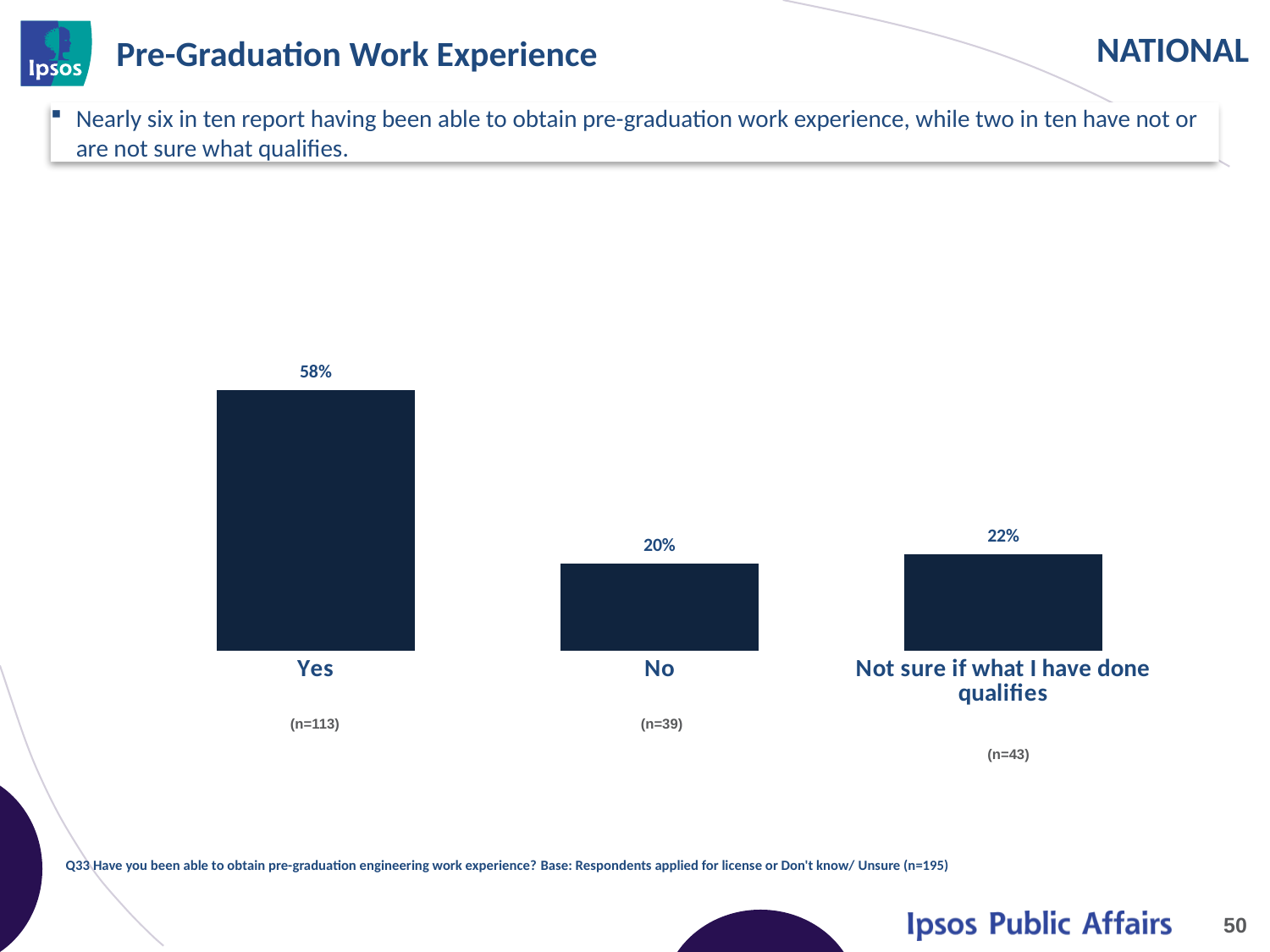
What percentage of respondents answered "Yes"? 58% What is the difference in percentage points between "Yes" and "No"? 38 Which response category has the highest value? Yes Which is larger, the value for "Yes" or the value for "Not sure if what I have done qualifies"? Yes Which response category has the lowest value? No What percentage of respondents answered "Not sure if what I have done qualifies"? 22% What is the sample size (n) shown under the "No" bar? (n=39) What percentage of respondents answered "No"? 20% How many response categories are shown in the chart? 3 What kind of chart is shown on the slide? Bar chart What is the title of the slide containing the chart? Pre-Graduation Work Experience What is the difference in percentage points between "Not sure if what I have done qualifies" and "No"? 2